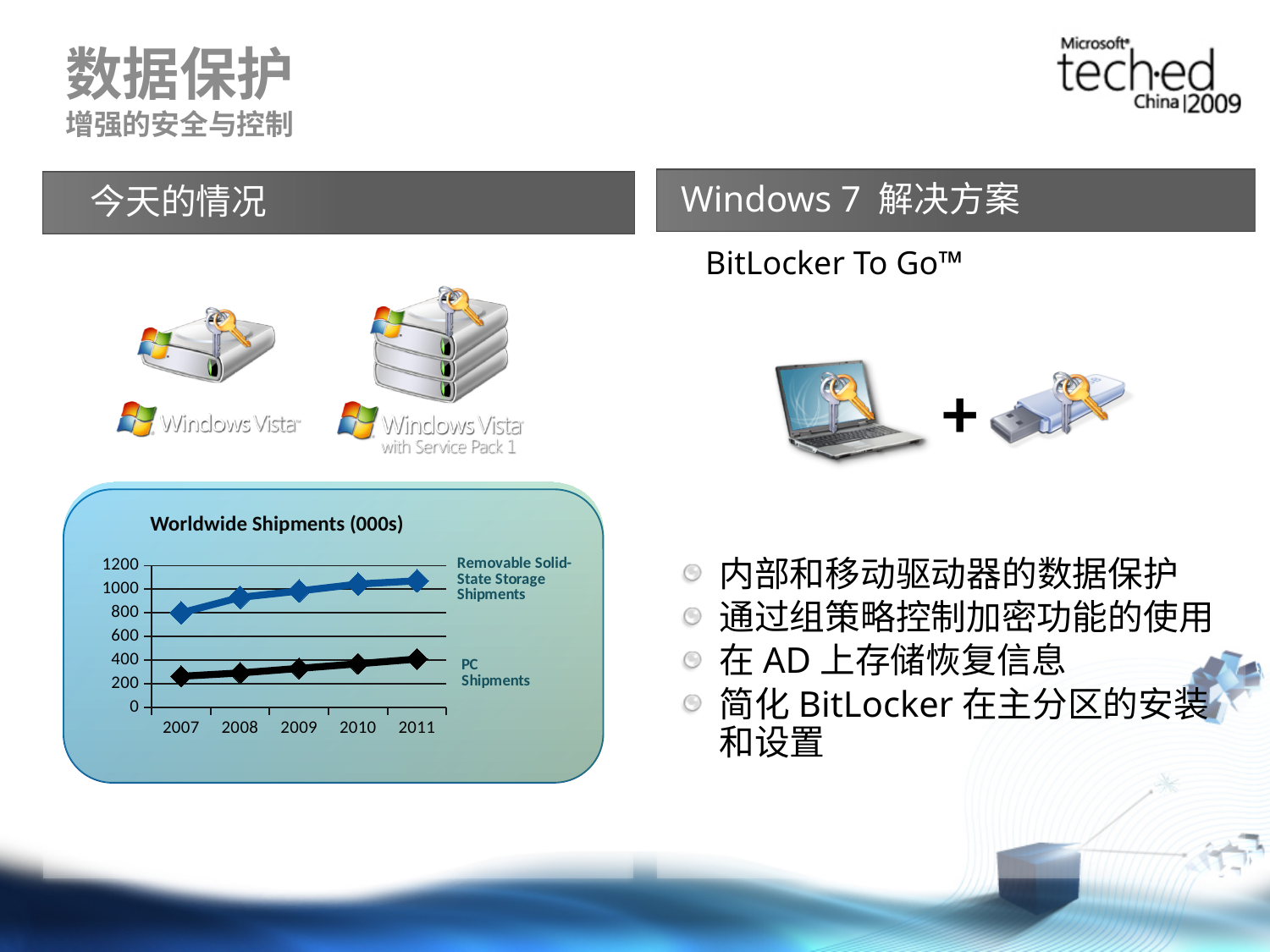
In the "Worldwide Shipments (000s)" chart, which year has the lowest value for Removable Solid-State Storage Shipments? 2007 In the "Worldwide Shipments (000s)" chart, do the values for PC Shipments rise or fall from 2007 to 2011? rise What is the title of the chart on the slide? Worldwide Shipments (000s) In the "Worldwide Shipments (000s)" chart, is the value for PC Shipments in 2007 greater or less than 200? greater How many series does the legend of the "Worldwide Shipments (000s)" chart list? 2 In the "Worldwide Shipments (000s)" chart, is the value for Removable Solid-State Storage Shipments in 2007 greater or less than 1000? less In the "Worldwide Shipments (000s)" chart, is the value for Removable Solid-State Storage Shipments in 2011 greater or less than 1000? greater What kind of chart is shown under the title "Worldwide Shipments (000s)"? line chart In the "Worldwide Shipments (000s)" chart, which series has the larger value in 2009, Removable Solid-State Storage Shipments or PC Shipments? Removable Solid-State Storage Shipments In the "Worldwide Shipments (000s)" chart, which year has the highest value for PC Shipments? 2011 How many years are shown on the x axis of the "Worldwide Shipments (000s)" chart? 5